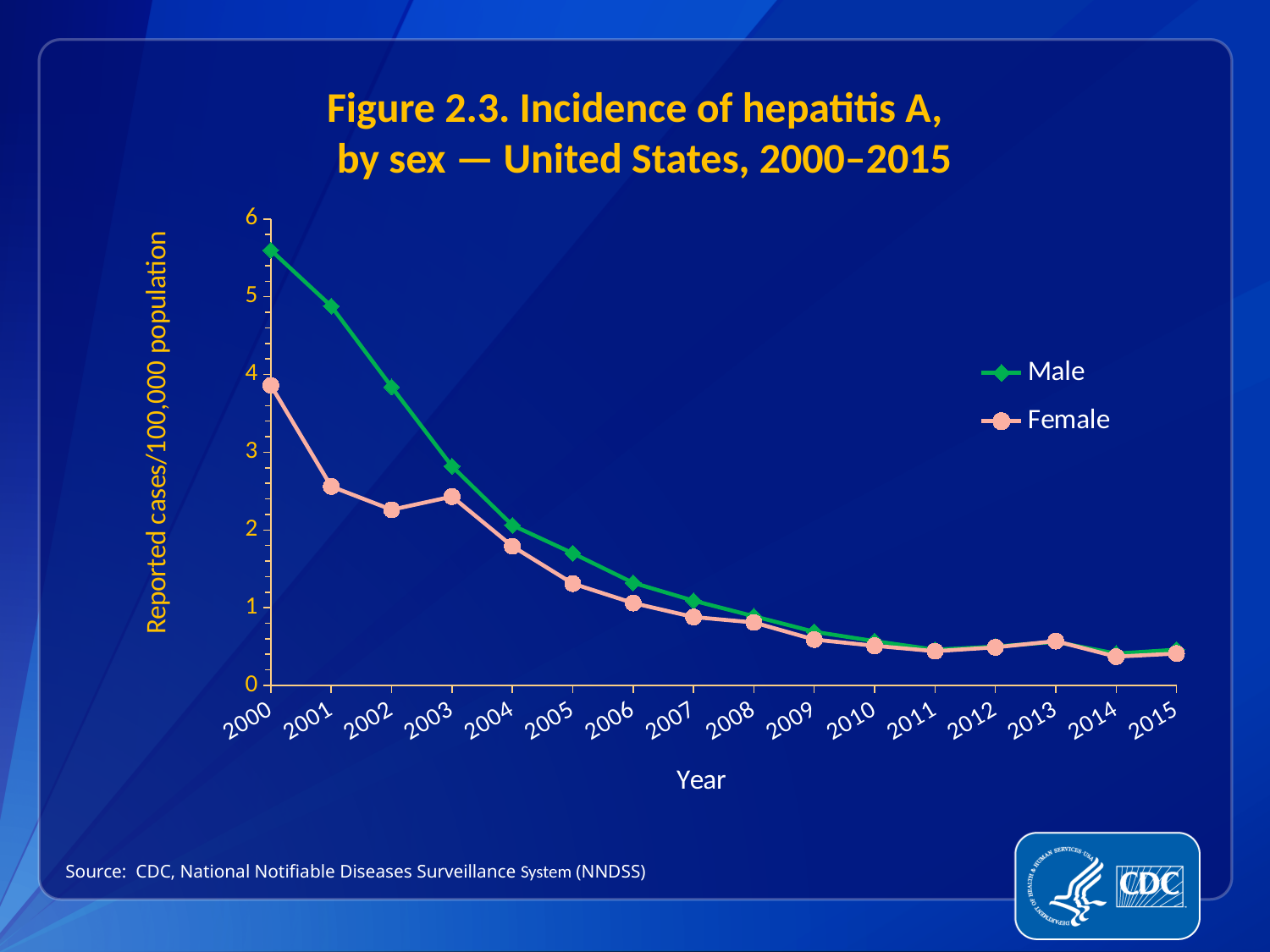
Is the Male value for 2000 greater or less than 5? greater What is the label on the y axis? Reported cases/100,000 population In which year is the Male incidence rate highest? 2000 In which year is the Female incidence rate highest? 2000 Does the Male incidence rate generally rise or fall from 2000 to 2015? fall Is the Male value for 2005 greater or less than 2? less How many years are plotted along the x axis? 16 How many series does the legend list? 2 What kind of chart is shown on the slide? line chart Is the Female value for 2001 greater or less than 3? less In 2002, which series has the higher incidence rate, Male or Female? Male